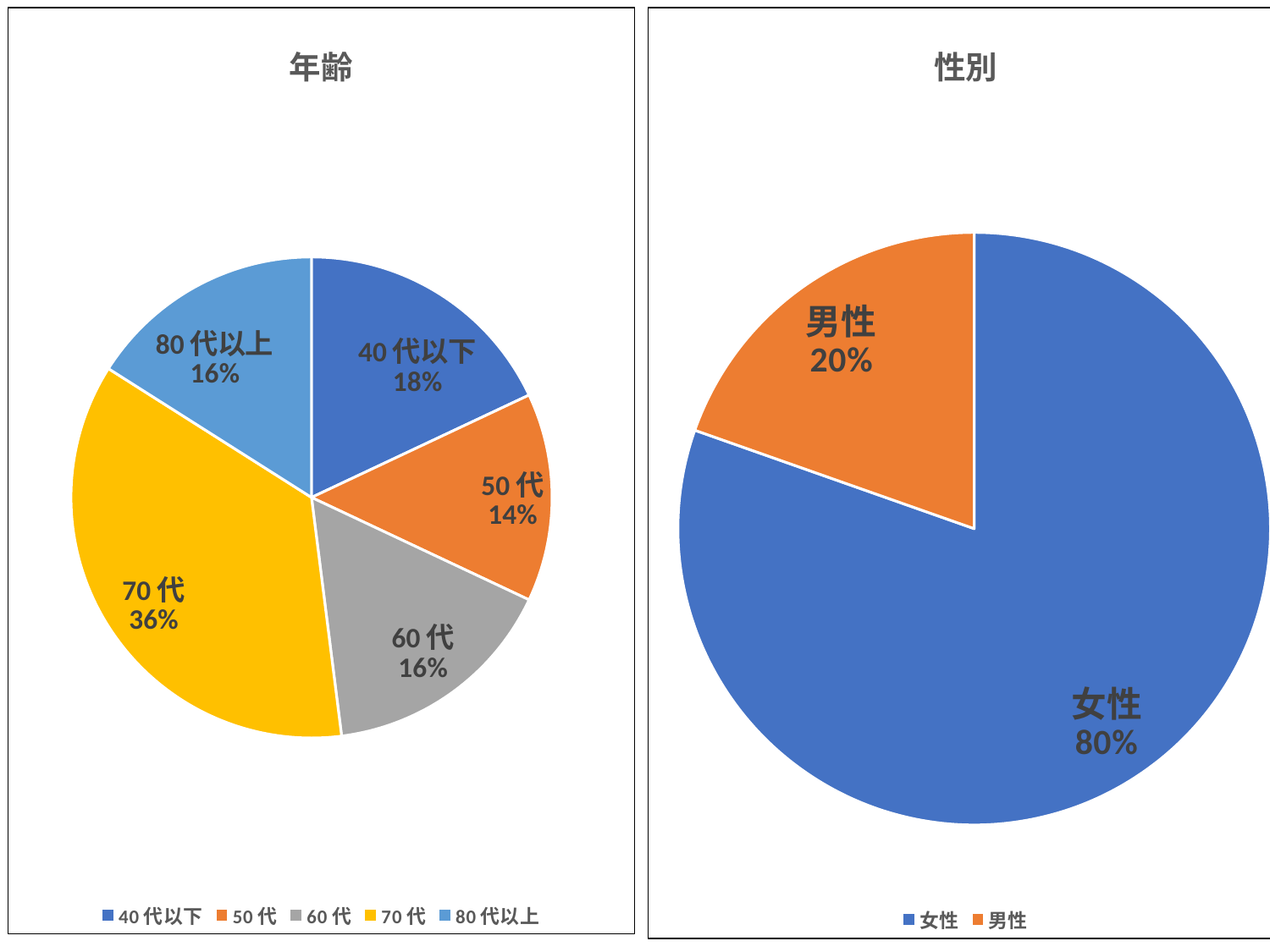
In the 年齢 chart, which category has the smallest share? 50 代 In the 年齢 chart, which category has the largest share? 70 代 How many categories does the 年齢 chart show? 5 What kind of chart is the 性別 chart? Pie chart In the 性別 chart, what share does 男性 have? 20% In the 年齢 chart, what share does 50 代 have? 14% In the 年齢 chart, what share does 40 代以下 have? 18% In the 年齢 chart, which is larger, 40 代以下 or 80 代以上? 40 代以下 In the 年齢 chart, what share does 70 代 have? 36% In the 性別 chart, what share does 女性 have? 80% In the 年齢 chart, what is the difference between the shares of 70 代 and 40 代以下? 18% In the 性別 chart, what is the difference between the shares of 女性 and 男性? 60%